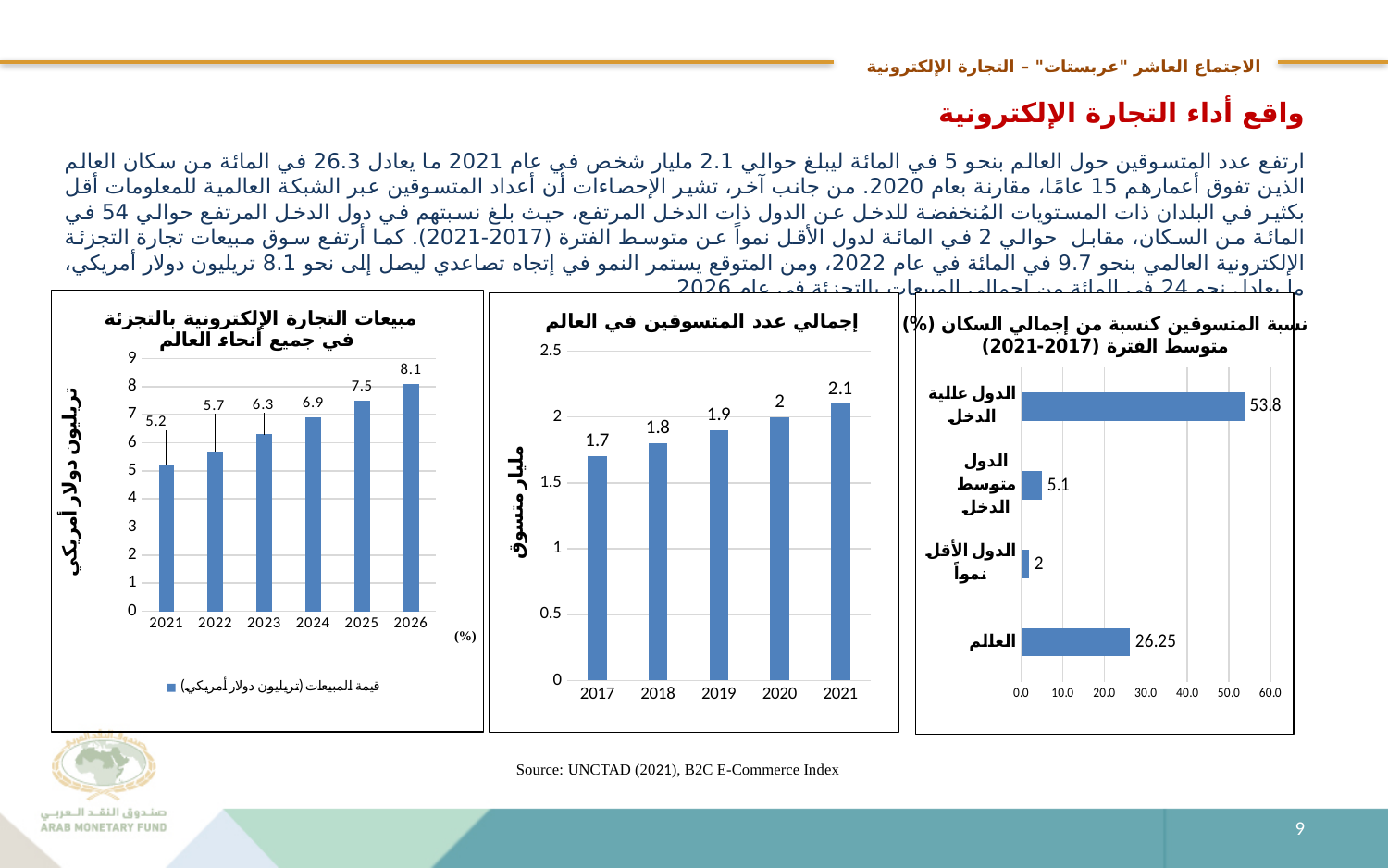
In the middle chart (total number of shoppers in the world), which year has the highest value? 2021 In the right chart (shoppers as a share of total population), what is the value for العالم (World)? 26.25 What type of chart is the right chart (shoppers as a share of total population)? bar chart In the right chart (shoppers as a share of total population), which category has the lowest value? الدول الأقل نمواً How many years are shown on the x axis of the left chart (retail e-commerce sales worldwide)? 6 In the left chart (retail e-commerce sales worldwide), what is the difference between the 2026 and 2021 values? 2.9 In the left chart (retail e-commerce sales worldwide), do the values rise or fall from 2021 to 2026? rise In the left chart (retail e-commerce sales worldwide), what is the value for 2021? 5.2 In the middle chart (total number of shoppers in the world), what is the value for 2019? 1.9 In the right chart (shoppers as a share of total population), what is the value for الدول عالية الدخل (high-income countries)? 53.8 In the left chart (retail e-commerce sales worldwide), what is the value for 2026? 8.1 In the middle chart (total number of shoppers in the world), which year has the lowest value? 2017